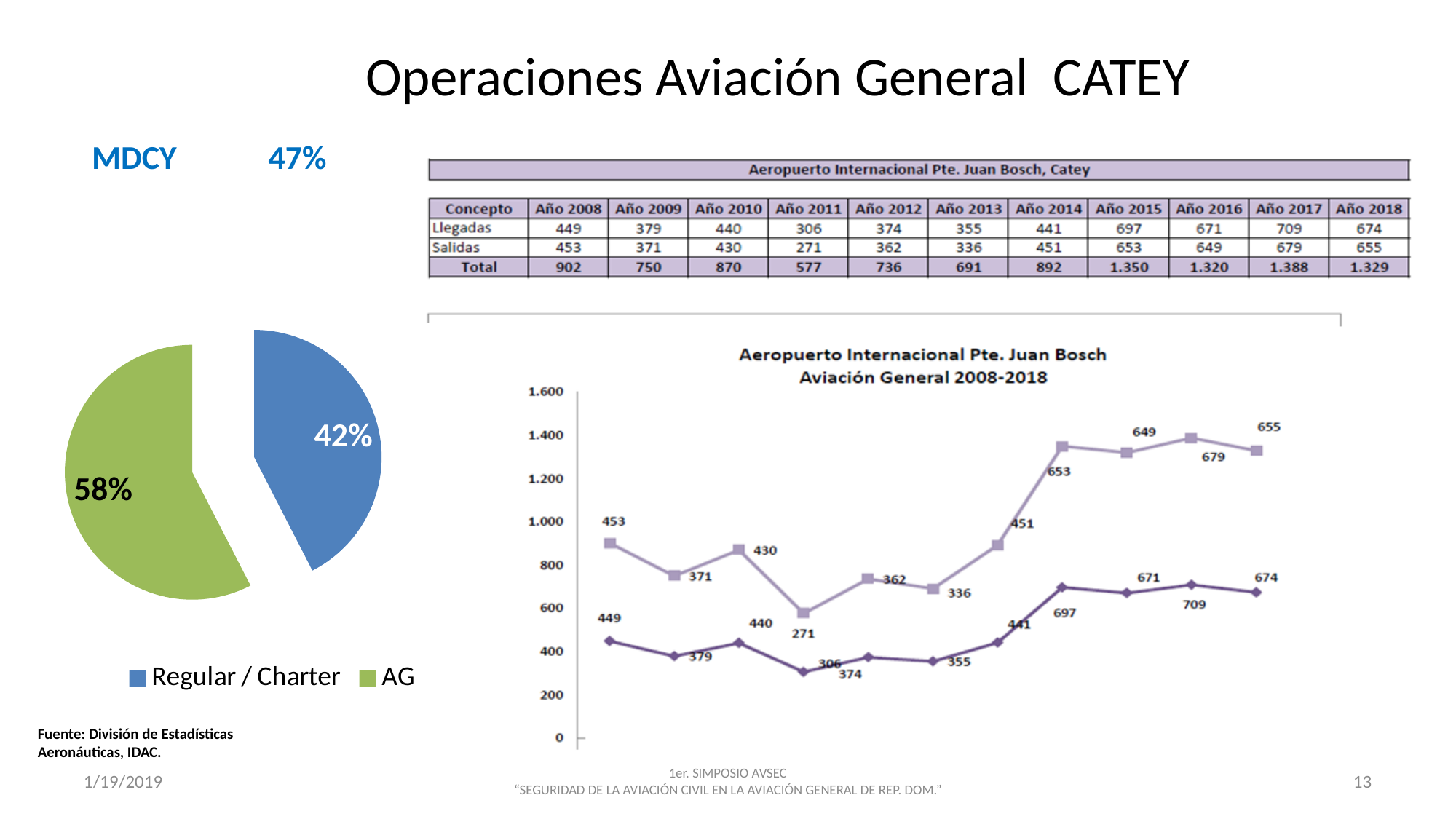
In the pie chart on the left, which colour is used for the AG slice? Green In the 'Aeropuerto Internacional Pte. Juan Bosch Aviación General 2008-2018' chart, what is the highest data label on the lower line? 709 In the pie chart on the left, which slice is larger, Regular / Charter or AG? AG How many data points does each line have in the 'Aeropuerto Internacional Pte. Juan Bosch Aviación General 2008-2018' chart? 11 In the 'Aeropuerto Internacional Pte. Juan Bosch Aviación General 2008-2018' chart, does the lower line end higher or lower than it starts? Higher How many slices does the pie chart on the left have? 2 In the pie chart on the left, what share does Regular / Charter have? 42% How many lines are plotted in the 'Aeropuerto Internacional Pte. Juan Bosch Aviación General 2008-2018' chart? 2 What kind of chart is the 'Aeropuerto Internacional Pte. Juan Bosch Aviación General 2008-2018' chart? Line chart What kind of chart is the chart on the left of the slide? Pie chart In the pie chart on the left, what share does AG have? 58% In the pie chart on the left, what is the difference in percentage points between the AG slice and the Regular / Charter slice? 16 percentage points